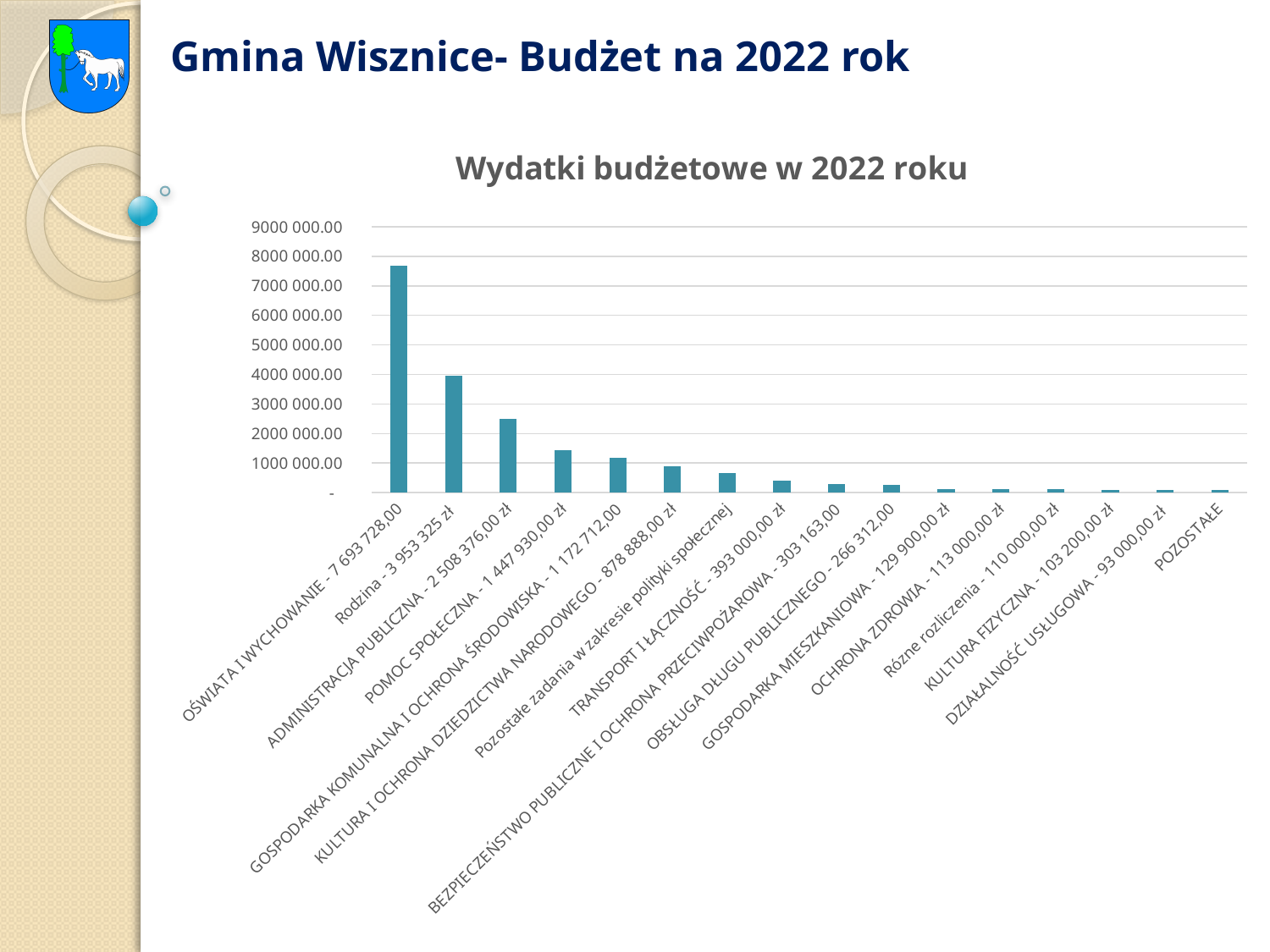
What value is given for TRANSPORT I ŁĄCZNOŚĆ in its category label? 393 000,00 zł What type of chart is shown on the slide? Bar chart What is the difference between the values for ADMINISTRACJA PUBLICZNA and POMOC SPOŁECZNA? 1 060 446,00 zł What value is given for DZIAŁALNOŚĆ USŁUGOWA in its category label? 93 000,00 zł Which category has the highest value in the chart? OŚWIATA I WYCHOWANIE What value is given for OŚWIATA I WYCHOWANIE in its category label? 7 693 728,00 What value is given for ADMINISTRACJA PUBLICZNA in its category label? 2 508 376,00 zł What is the title of the chart? Wydatki budżetowe w 2022 roku How many categories are plotted on the x axis of the chart? 16 Do the values rise or fall moving from left to right along the x axis? Fall Is the value for Pozostałe zadania w zakresie polityki społecznej greater or less than 1000 000.00? less Which is larger, the value for Rodzina or the value for POMOC SPOŁECZNA? Rodzina